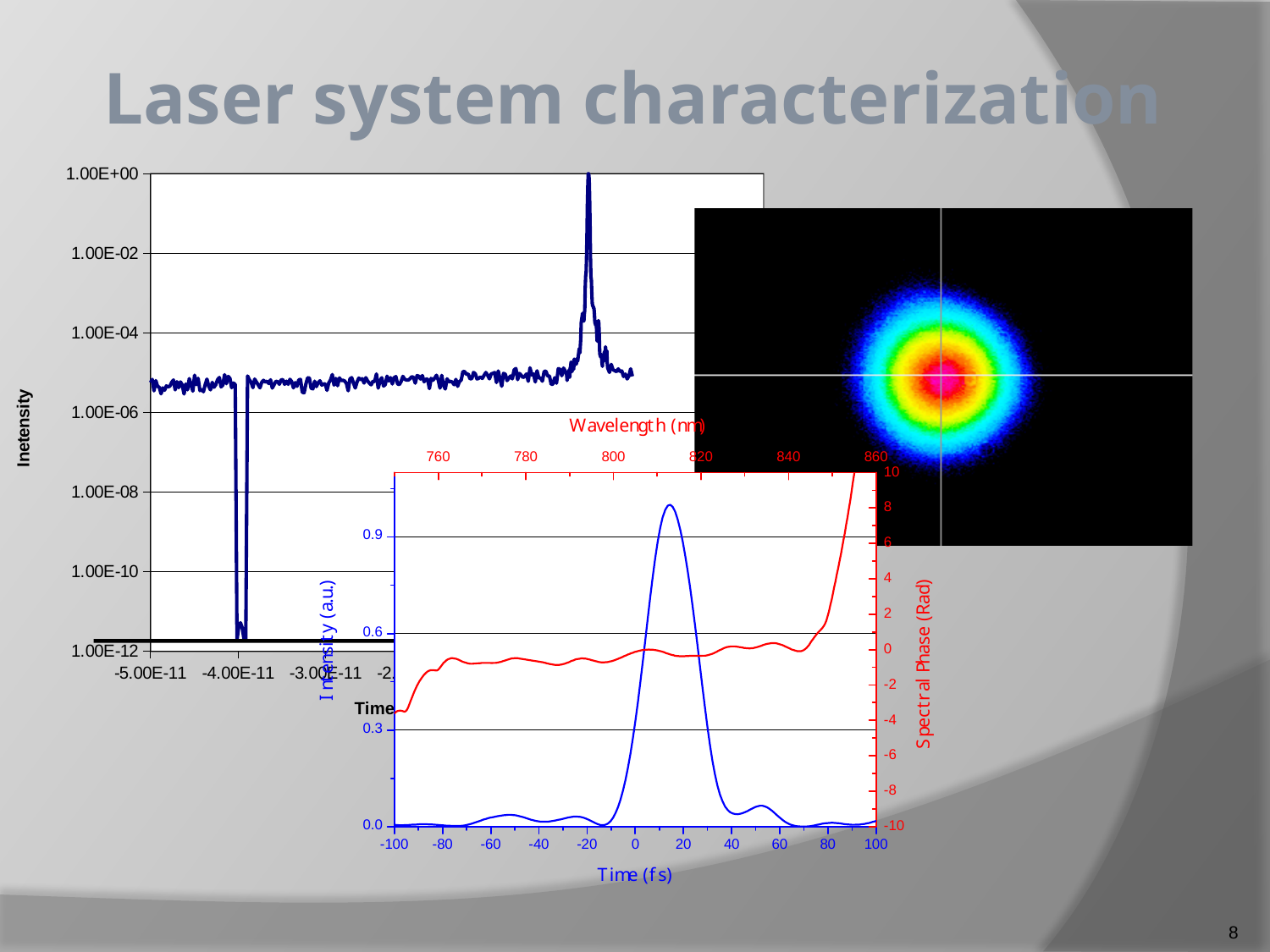
In the bottom chart with the Time (fs) axis, is the red spectral phase curve at the right end of the x axis greater or less than 8 Rad? greater What kind of chart is the chart at the bottom of the slide with the Time (fs) axis? line chart What is the label of the top x axis of the bottom chart with the Time (fs) axis? Wavelength (nm) How many lines are plotted in the bottom chart with the Time (fs) axis? 2 In the bottom chart with the Time (fs) axis, is the peak of the blue intensity curve greater or less than 0.9? greater In the bottom chart with the Time (fs) axis, does the red spectral phase curve rise or fall toward the right end of the x axis? rises In the top-left chart, is the flat baseline level of the dark blue line greater or less than 1.00E-04? less In the bottom chart with the Time (fs) axis, does the blue intensity curve rise or fall between 20 fs and 40 fs? falls What is the label of the right-hand y axis of the bottom chart with the Time (fs) axis? Spectral Phase (Rad) What kind of chart is the large chart at the top left of the slide? line chart